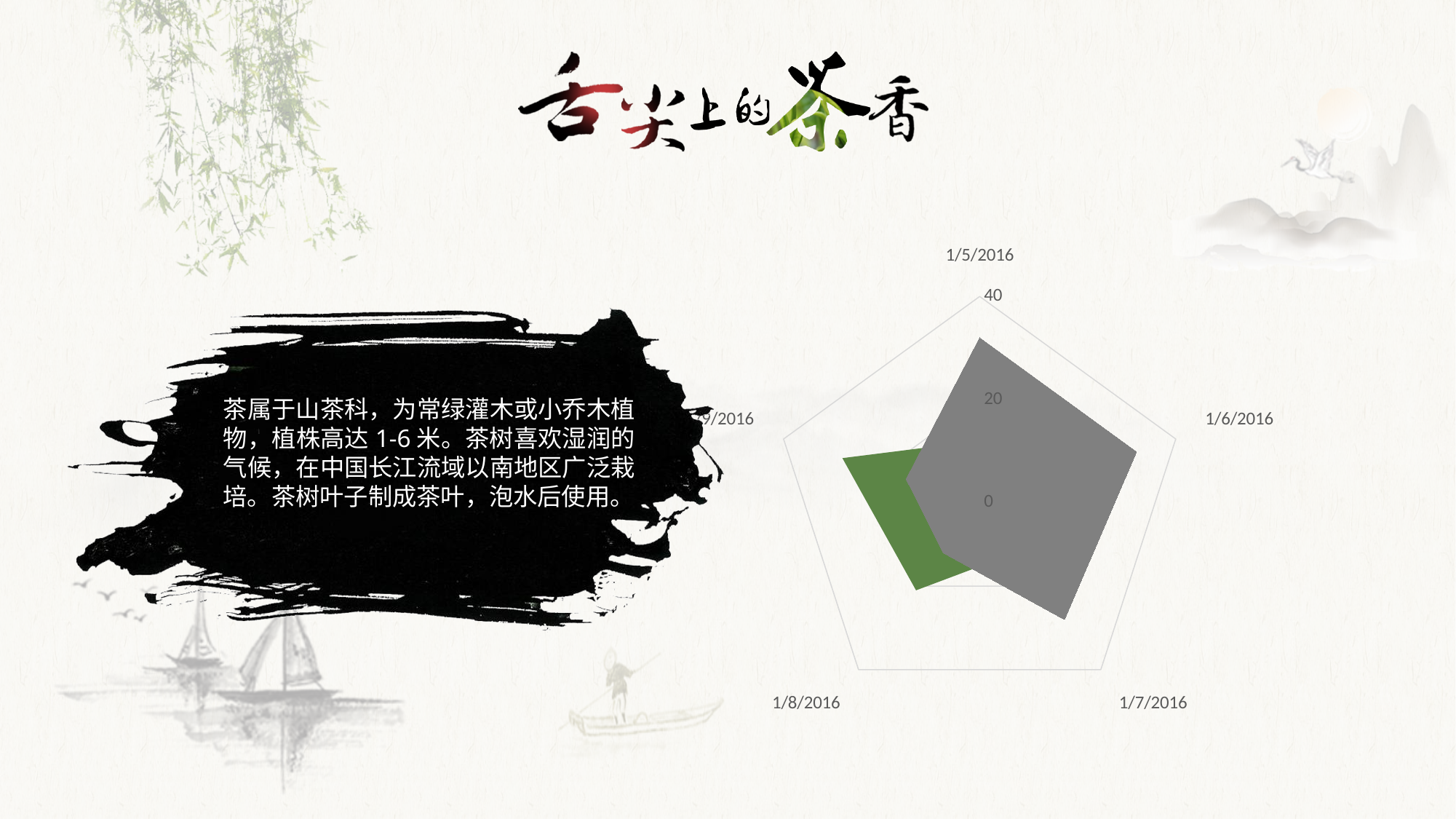
Is the green series' value for 1/9/2016 greater or less than 40? less At 1/9/2016, which series has the larger value, gray or green? green How many categories (dates) are plotted around the radar chart? 5 Is the gray series' value for 1/5/2016 greater or less than 40? less Is the green series' value for 1/9/2016 greater or less than 20? greater What is the highest value shown on the radar chart's axis? 40 What kind of chart is shown on the slide? radar chart At 1/5/2016, which series has the larger value, gray or green? gray How many data series are plotted on the radar chart? 2 What two colours are used for the filled series on the radar chart? gray and green